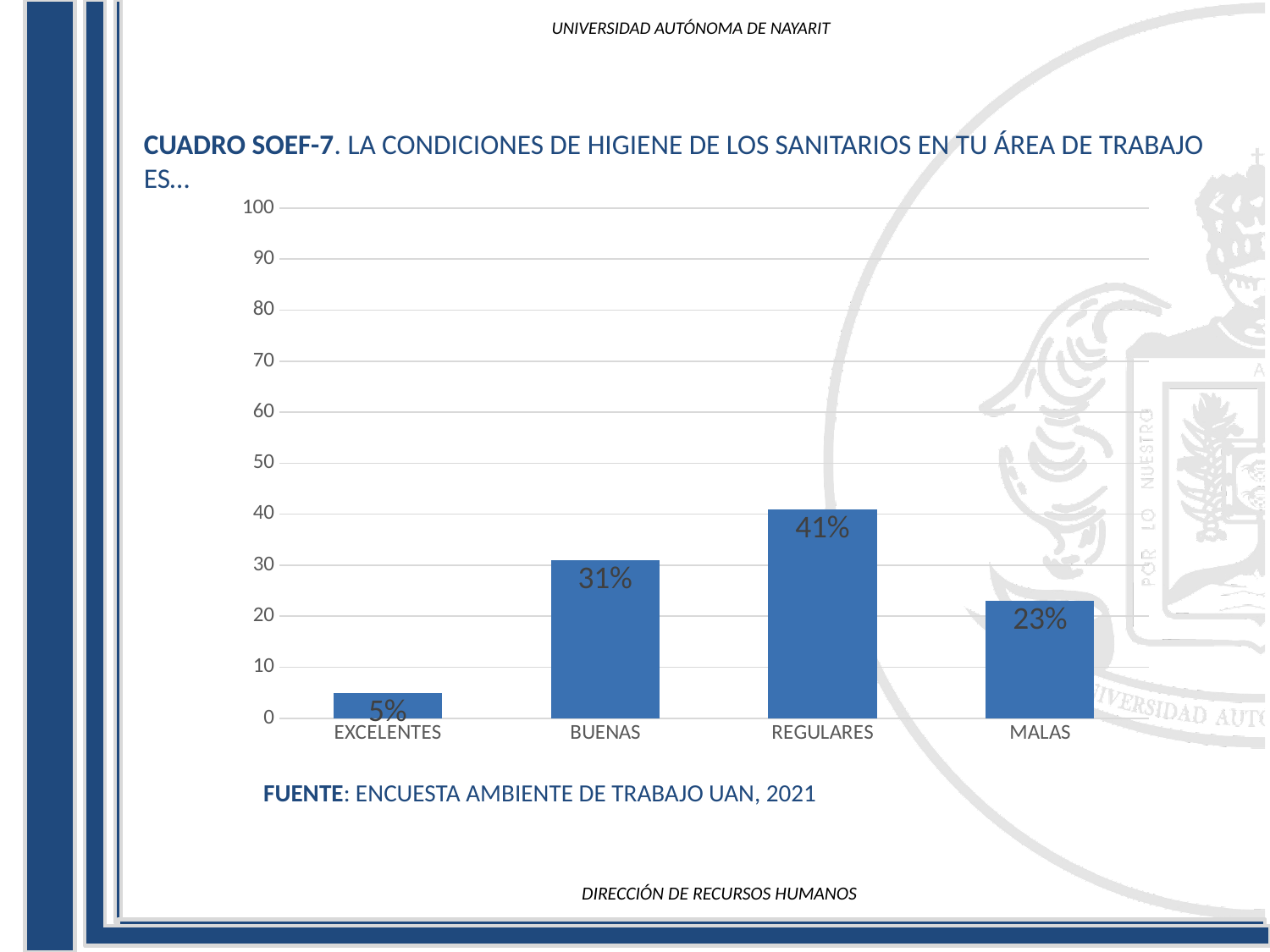
What is the value for EXCELENTES? 5% What is the value for REGULARES? 41% What is the value for BUENAS? 31% Is the value for MALAS greater or less than 30? less What is the difference between the values for REGULARES and BUENAS? 10% Which is larger, the value for BUENAS or the value for MALAS? BUENAS What is the value for MALAS? 23% Which category has the lowest value? EXCELENTES What kind of chart is shown on the slide? bar chart Which category has the highest value? REGULARES What source is cited below the chart? ENCUESTA AMBIENTE DE TRABAJO UAN, 2021 How many categories are shown on the x axis? 4